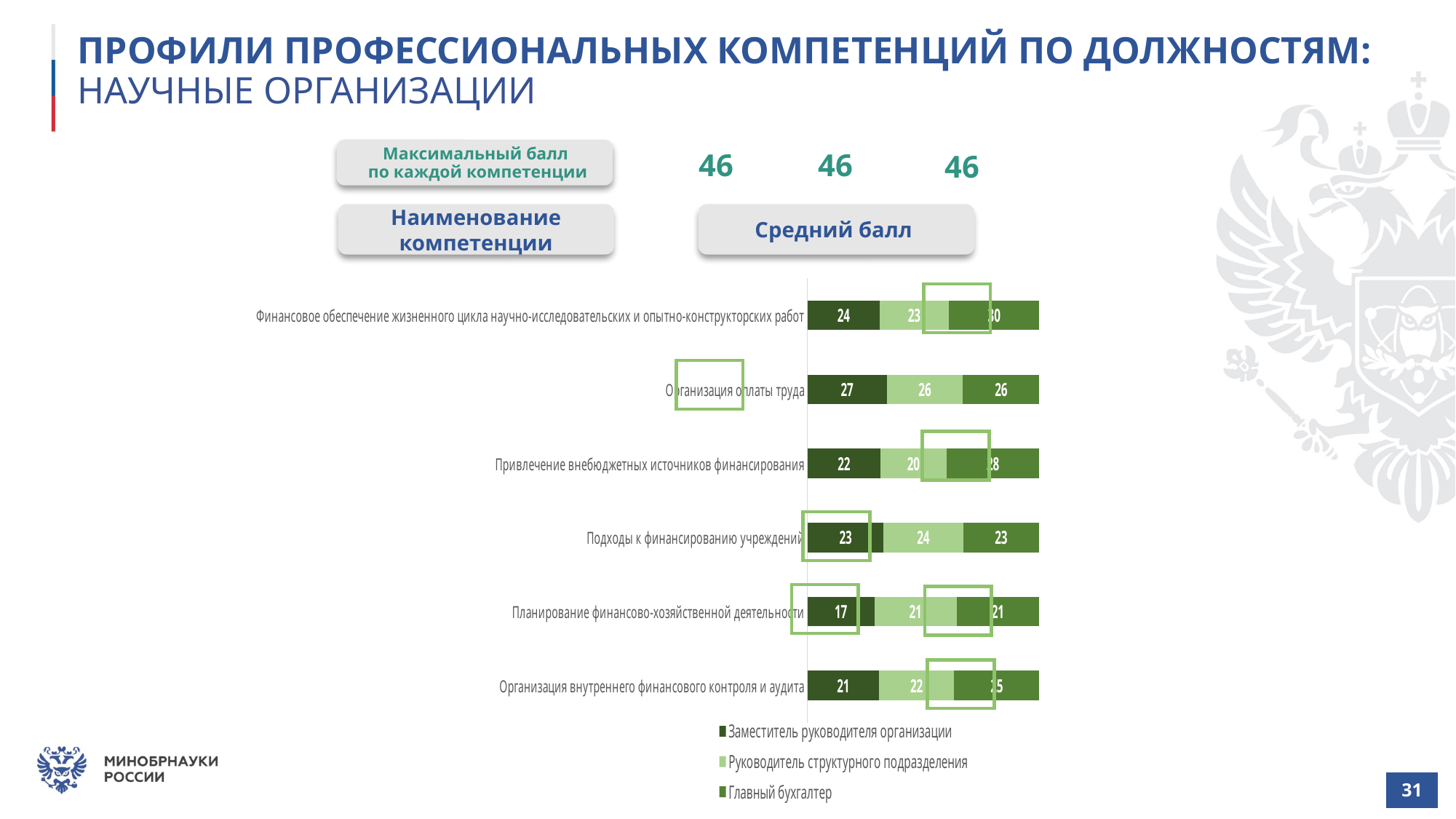
What is the difference between the Заместитель руководителя организации values for Организация оплаты труда and Планирование финансово-хозяйственной деятельности? 10 For which competency is the Заместитель руководителя организации value the lowest? Планирование финансово-хозяйственной деятельности What kind of chart is shown on the slide? Stacked bar chart What is the total of the stacked bar for Организация оплаты труда? 79 What is the value for Заместитель руководителя организации for Организация оплаты труда? 27 Which is larger for Привлечение внебюджетных источников финансирования: the Заместитель руководителя организации value or the Руководитель структурного подразделения value? Заместитель руководителя организации How many competencies (categories) are plotted in the chart? 6 What is the value for Заместитель руководителя организации for Планирование финансово-хозяйственной деятельности? 17 What is the value for Главный бухгалтер for Организация оплаты труда? 26 How many series does the chart legend list? 3 For which competency is the Заместитель руководителя организации value the highest? Организация оплаты труда What is the value for Руководитель структурного подразделения for Подходы к финансированию учреждений? 24